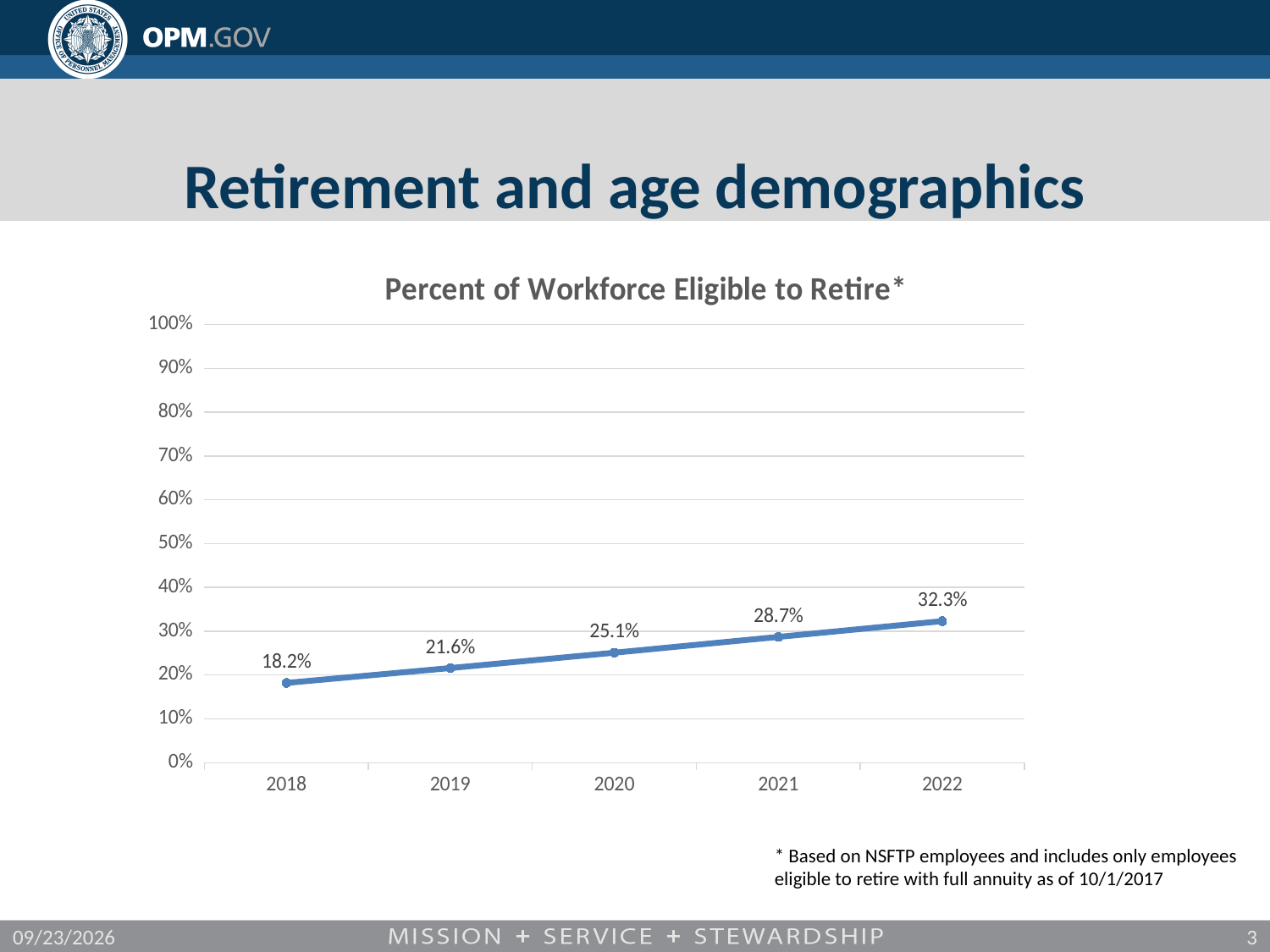
Do the values rise or fall from 2018 to 2022? rise Which year has a larger value, 2019 or 2021? 2021 What is the percent of workforce eligible to retire in 2022? 32.3% How many years are plotted on the chart? 5 What is the difference in percentage points between the 2022 and 2018 values? 14.1 Which year has the lowest percent of workforce eligible to retire? 2018 What kind of chart is shown on the slide? line chart Is the value for 2021 greater or less than 30%? less What is the percent of workforce eligible to retire in 2018? 18.2% Which year has the highest percent of workforce eligible to retire? 2022 What is the title of the chart? Percent of Workforce Eligible to Retire* What is the percent of workforce eligible to retire in 2020? 25.1%